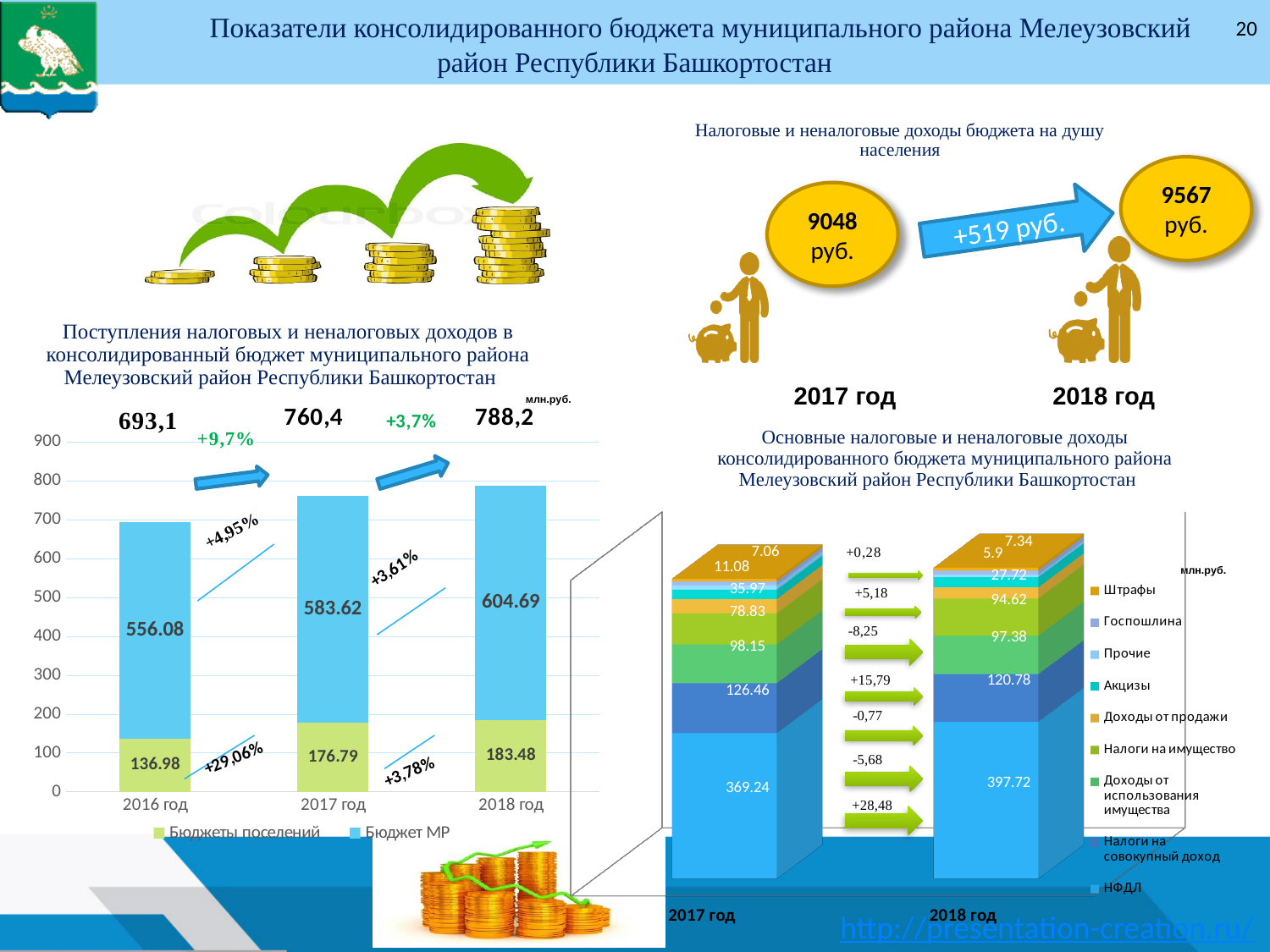
In the left chart 'Поступления налоговых и неналоговых доходов', what is the value for 'Бюджеты поселений' in 2016 год? 136.98 In the left chart 'Поступления налоговых и неналоговых доходов', which year has the highest value for 'Бюджет МР'? 2018 год In the right chart 'Основные налоговые и неналоговые доходы', which year has the larger bottom segment (НДФЛ): 2017 год or 2018 год? 2018 год In the right chart 'Основные налоговые и неналоговые доходы', how many series does the legend list? 9 What kind of chart is the left chart 'Поступления налоговых и неналоговых доходов'? stacked bar chart In the left chart 'Поступления налоговых и неналоговых доходов', what is the difference between 'Бюджеты поселений' in 2018 год and in 2017 год? 6.69 In the left chart 'Поступления налоговых и неналоговых доходов', which year has the lowest value for 'Бюджеты поселений'? 2016 год In the left chart 'Поступления налоговых и неналоговых доходов', how many series does the legend list? 2 In the left chart 'Поступления налоговых и неналоговых доходов', what is the total shown above the bar for 2018 год? 788,2 In the left chart 'Поступления налоговых и неналоговых доходов', do the total values rise or fall from 2016 год to 2018 год? rise In the right chart 'Основные налоговые и неналоговые доходы', what is the value of the bottom segment (НДФЛ) for 2018 год? 397.72 In the left chart 'Поступления налоговых и неналоговых доходов', what is the value for 'Бюджет МР' in 2017 год? 583.62